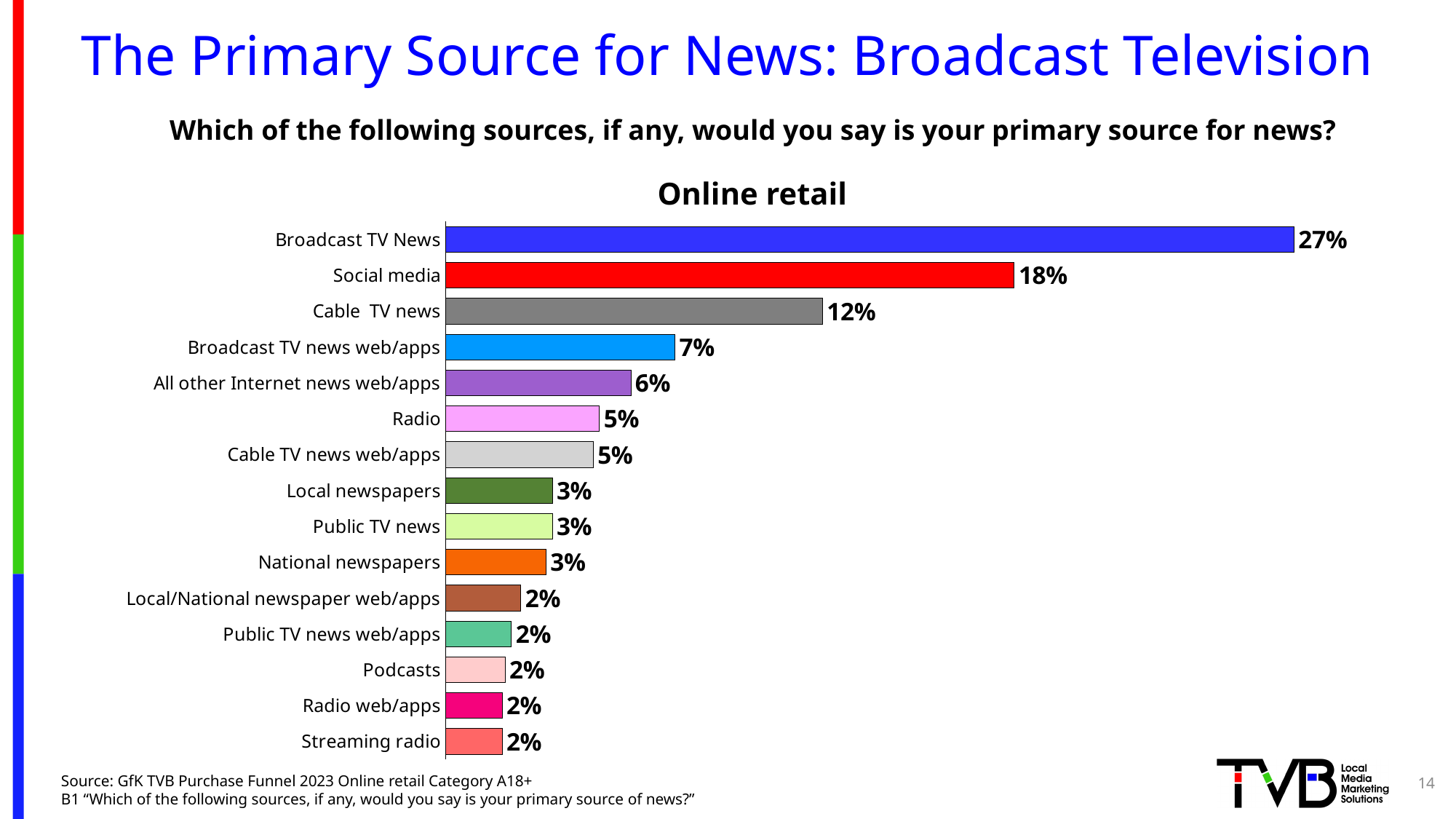
What is the value shown for Social media? 18% Which is larger, the value for Radio or the value for All other Internet news web/apps? All other Internet news web/apps What colour is the bar for Social media? Red What is the value shown for Broadcast TV news web/apps? 7% What is the difference between the values for Social media and Cable TV news? 6 percentage points What percentage of respondents named Broadcast TV News as their primary source for news? 27% Which source has the highest value in the chart? Broadcast TV News What is the title of the chart? Online retail What is the value shown for Cable TV news? 12% What kind of chart is shown on the slide? Bar chart How many sources (categories) are shown in the chart? 15 What is the difference between the values for Broadcast TV News and Social media? 9 percentage points